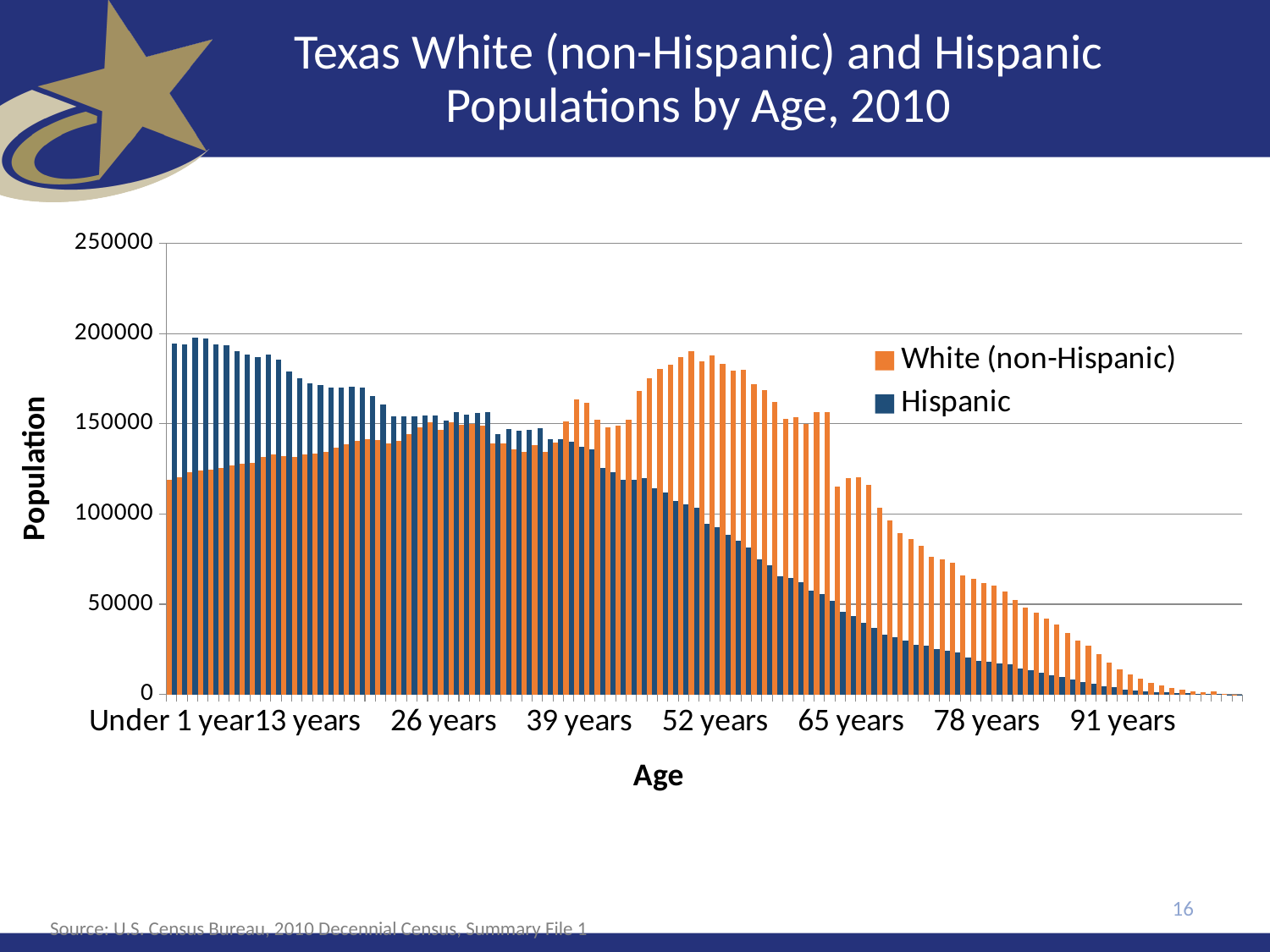
Is the White (non-Hispanic) value for 52 years greater or less than 150000? greater How many series does the legend list? 2 Is the Hispanic value for Under 1 year greater or less than 150000? greater At Under 1 year, which series has the larger value, White (non-Hispanic) or Hispanic? Hispanic At 52 years, which series has the larger value, White (non-Hispanic) or Hispanic? White (non-Hispanic) Which colour represents the Hispanic series? blue Is the White (non-Hispanic) value for 78 years greater or less than 50000? greater Do the Hispanic values generally rise or fall as age increases along the x axis? fall What kind of chart is shown on the slide? bar chart What is the title of the chart? Texas White (non-Hispanic) and Hispanic Populations by Age, 2010